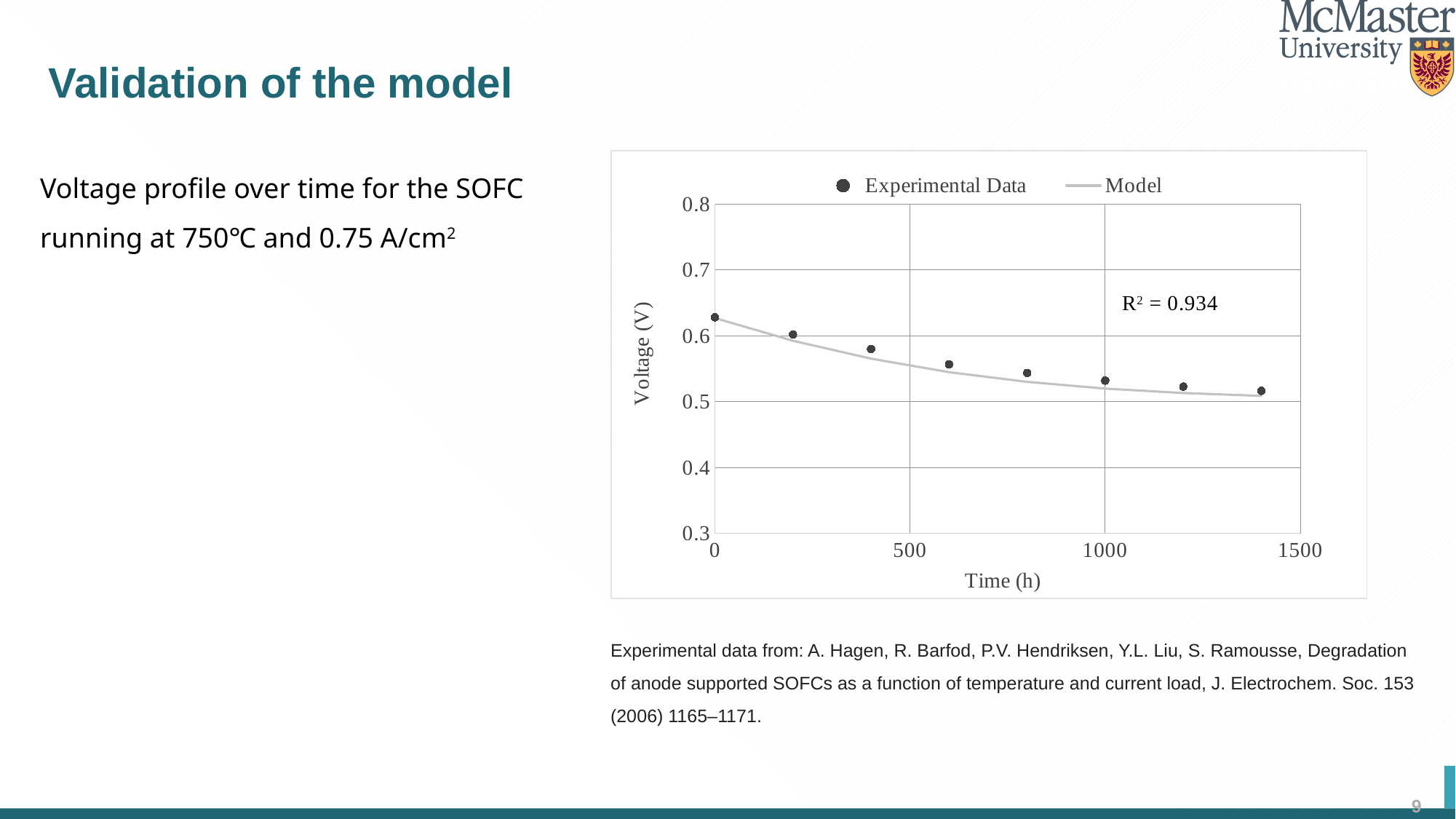
Is the experimental voltage at 1000 h greater or less than 0.5? greater Which is larger, the experimental voltage at 200 h or at 800 h? 200 h At which time is the experimental voltage highest? 0 h How many series does the chart legend list? 2 What R² value is printed on the chart? 0.934 How many experimental data points are plotted on the chart? 8 What are the two series named in the chart legend? Experimental Data and Model Is the experimental voltage at 1400 h greater or less than 0.6? less Is the experimental voltage at 0 h greater or less than 0.6? greater What kind of chart is shown on the slide? Scatter chart with a fitted line What is the label of the y axis of the chart? Voltage (V) Does the voltage rise or fall as time increases along the x axis? Fall